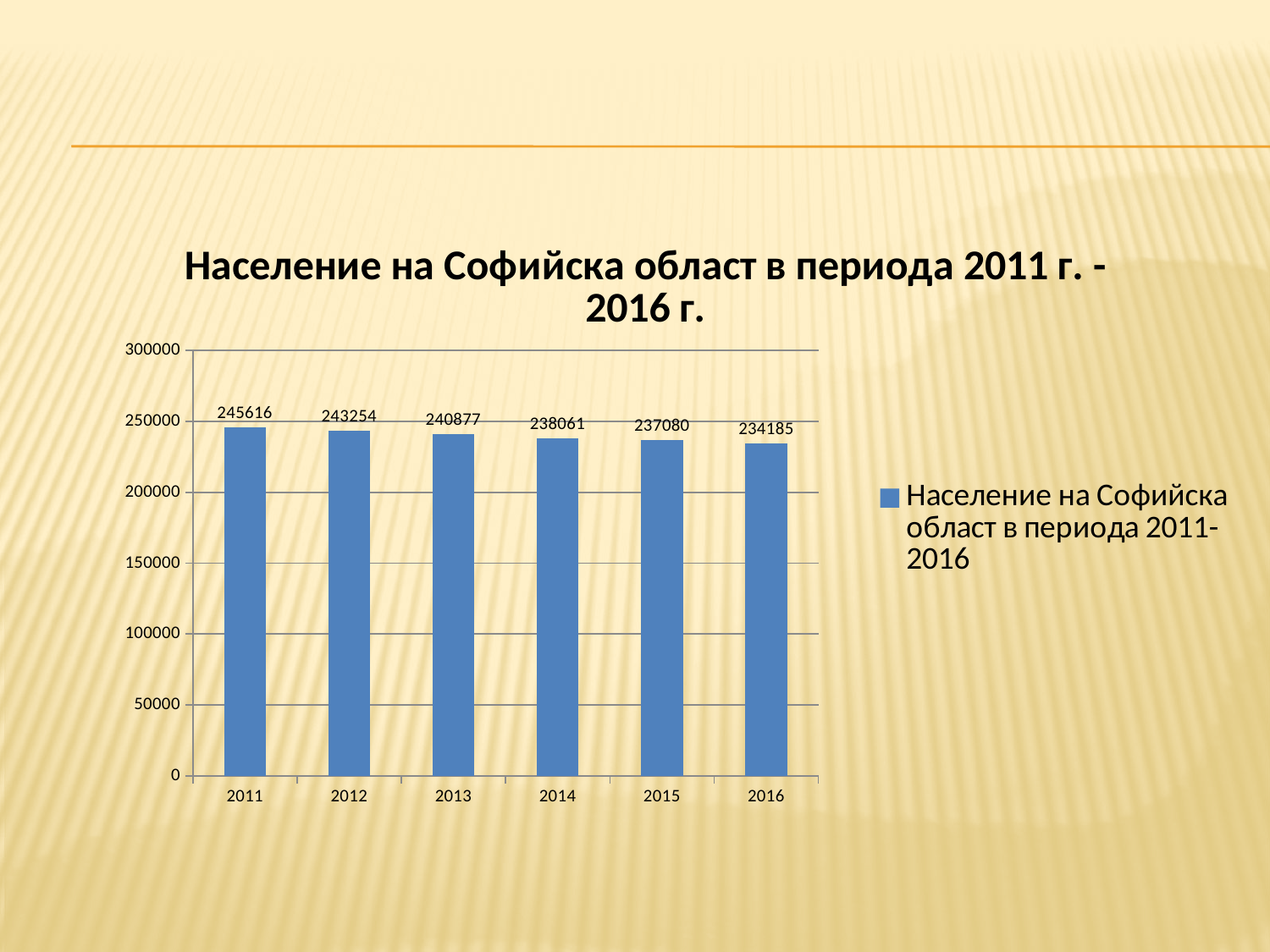
What is the population value shown for 2014? 238061 Which is larger, the value for 2013 or the value for 2015? 2013 What is the difference between the population values for 2012 and 2013? 2377 Do the values rise or fall from 2011 to 2016? fall Is the value for 2012 greater or less than 250000? less What is the population value shown for 2016? 234185 What is the population value shown for 2011? 245616 What kind of chart is shown on the slide? bar chart How many years are shown on the x axis? 6 What is the difference between the population values for 2011 and 2016? 11431 Which year has the lowest population value? 2016 Which year has the highest population value? 2011